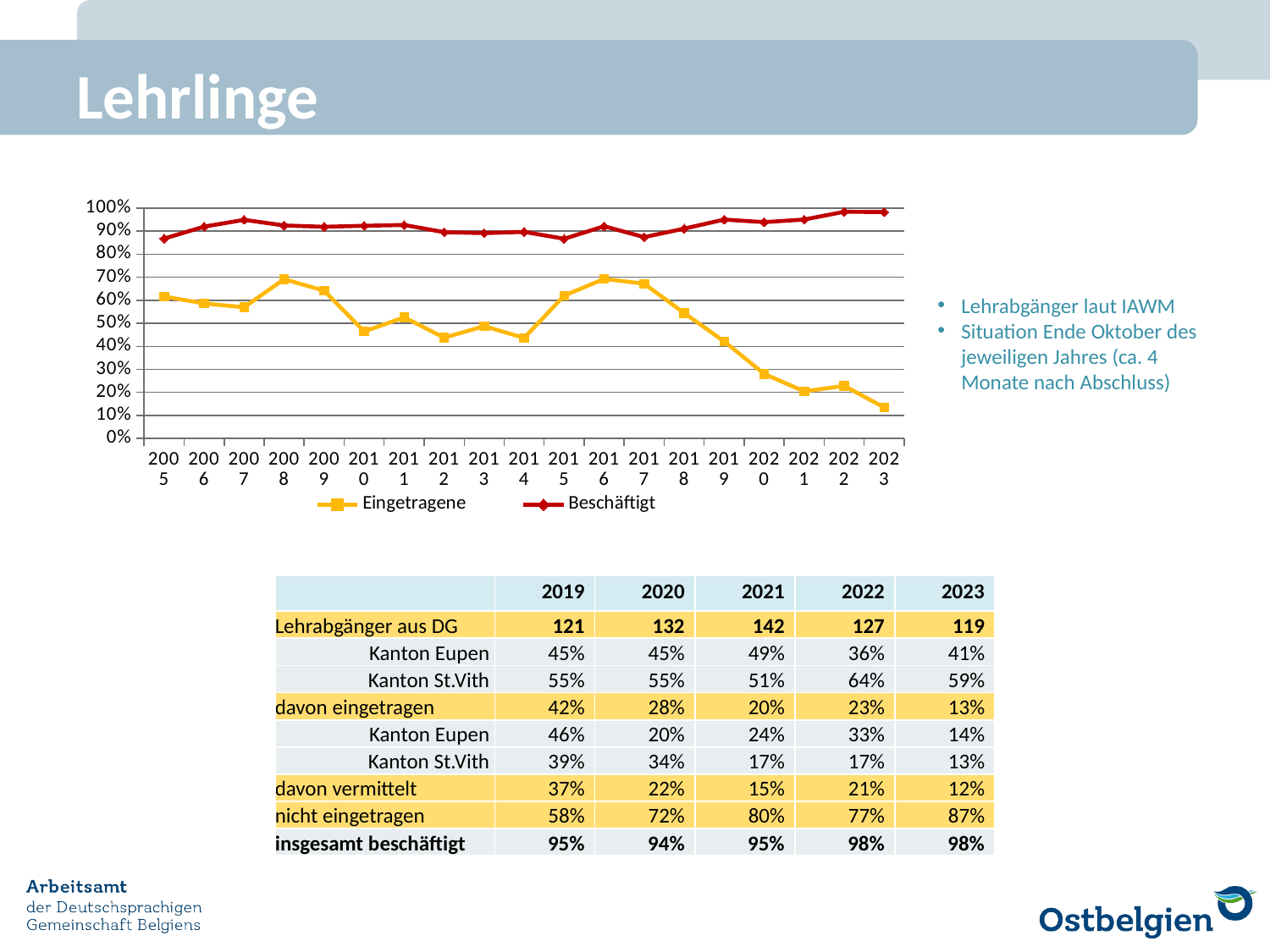
How many years are plotted along the x axis of the chart? 19 Is the value for Eingetragene in 2010 greater or less than 50%? less Is the value for Beschäftigt in 2005 greater or less than 80%? greater How many series does the chart's legend list? 2 Which series has the higher value in 2023, Eingetragene or Beschäftigt? Beschäftigt Does the Eingetragene series rise or fall from 2016 to 2023? fall What are the two series named in the chart's legend? Eingetragene and Beschäftigt Which is higher for Eingetragene: the value in 2016 or the value in 2021? 2016 In which year is the Eingetragene series at its lowest? 2023 What is the value for Beschäftigt in 2023, as printed in the table on the slide? 98% Is the value for Eingetragene in 2023 greater or less than 20%? less What kind of chart is shown on the slide? line chart